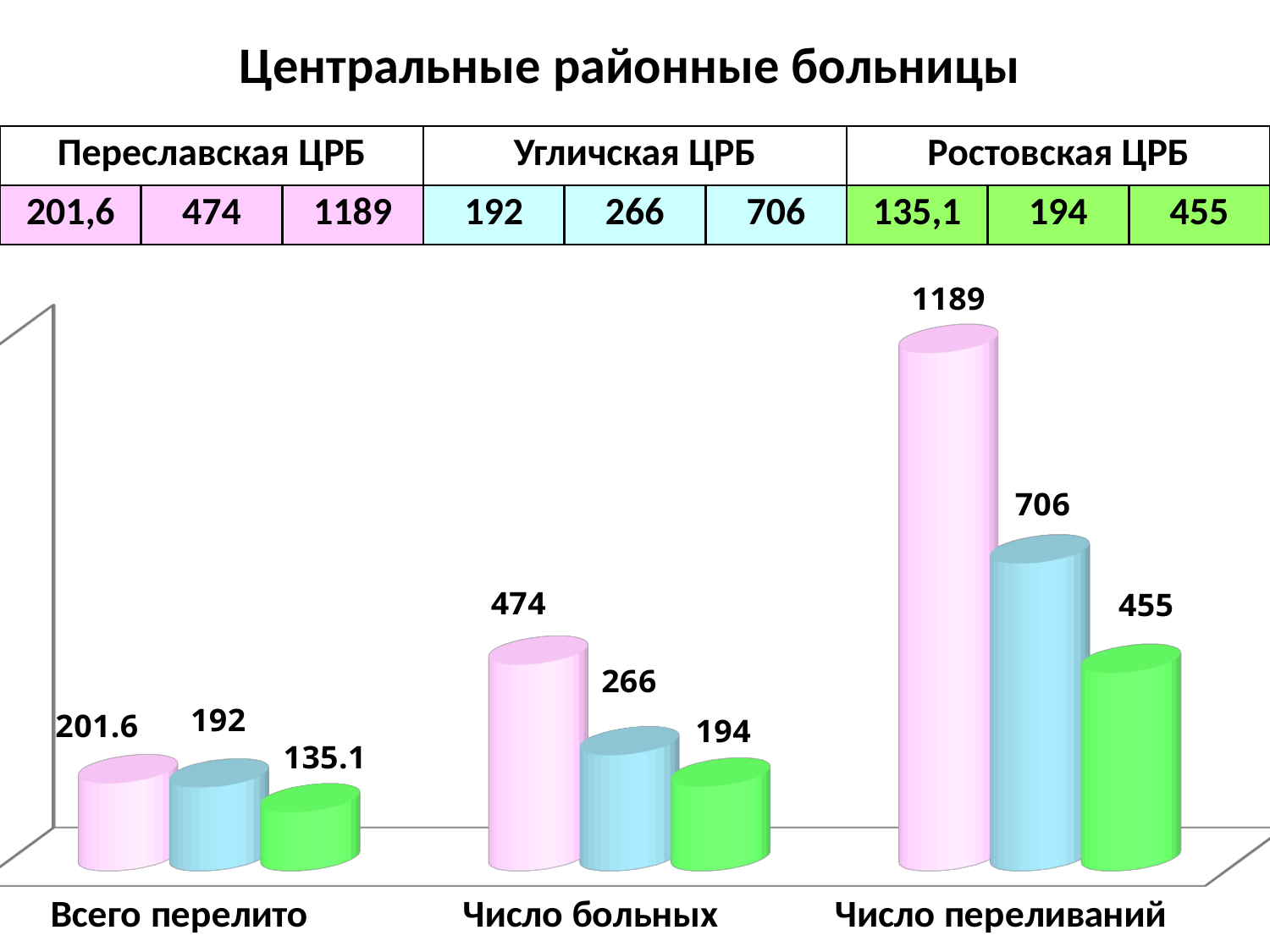
What is the value of the green bar (Ростовская ЦРБ) for Всего перелито? 135.1 Which is larger for Всего перелито: the pink bar (Переславская ЦРБ) or the blue bar (Угличская ЦРБ)? Переславская ЦРБ How many categories are shown along the x axis of the chart? 3 What is the title of the slide above the chart? Центральные районные больницы What is the difference between the pink bar and the blue bar for Число переливаний? 483 What is the value of the pink bar (Переславская ЦРБ) for Число переливаний? 1189 What is the difference between the pink bar and the green bar for Число больных? 280 Do the values of the pink bars rise or fall from Всего перелито to Число переливаний? rise What kind of chart is shown on the slide? bar chart Which hospital has the highest value for Число переливаний? Переславская ЦРБ Which hospital has the lowest value for Число больных? Ростовская ЦРБ What is the value of the blue bar (Угличская ЦРБ) for Число больных? 266